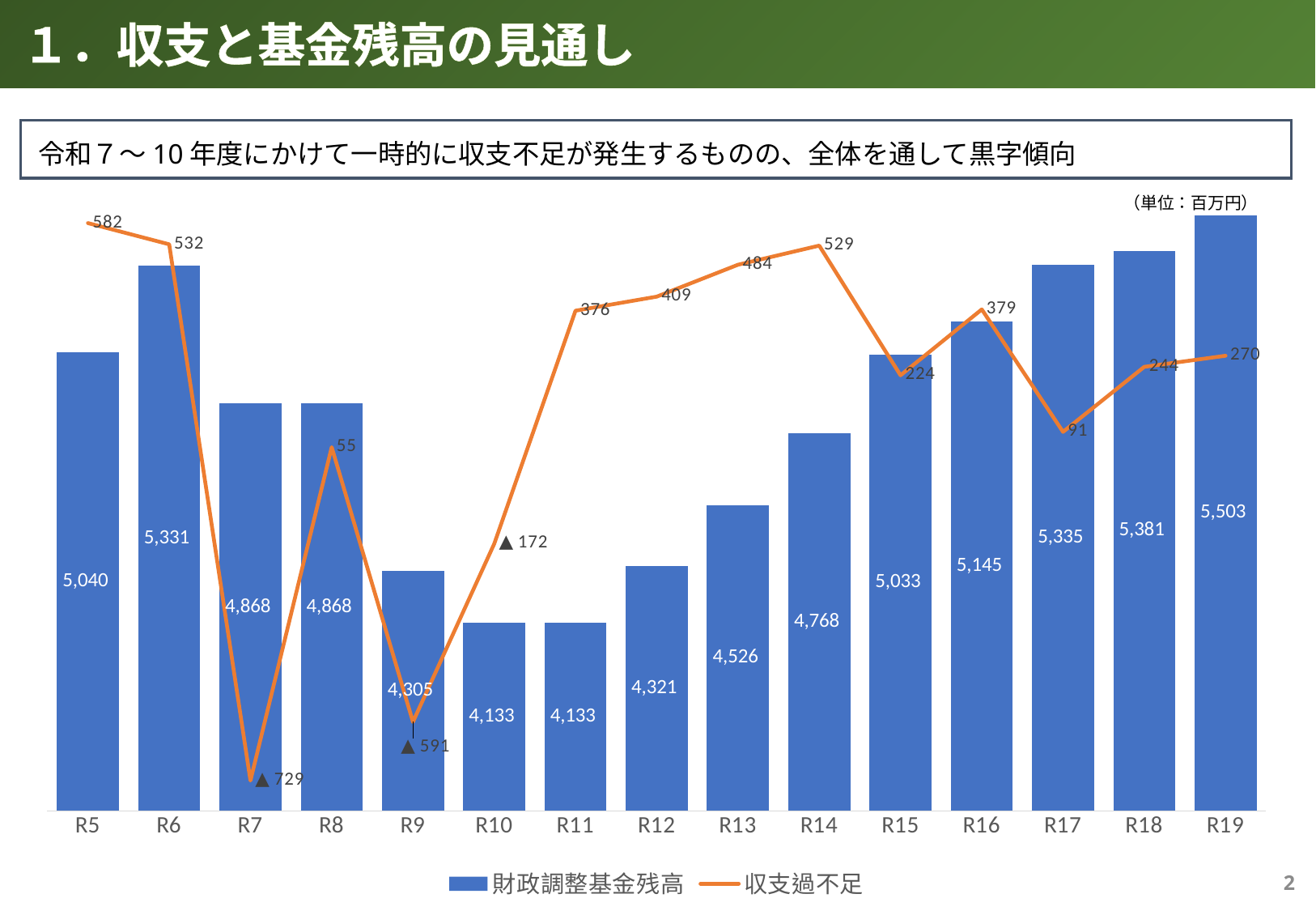
Which year has the highest 財政調整基金残高? R19 How many series does the legend list? 2 What is the 収支過不足 value for R7? ▲ 729 Do the 財政調整基金残高 values rise or fall from R11 to R19? Rise Which year has the lowest 収支過不足 value? R7 How many years are shown on the x axis? 15 What is the difference between the 財政調整基金残高 for R19 and R18? 122 What is the 収支過不足 value for R14? 529 What kind of chart is this? Combined bar and line chart Which is larger, the 収支過不足 for R13 or for R16? R13 What is the 財政調整基金残高 value for R9? 4,305 What unit is stated for the chart values? 百万円